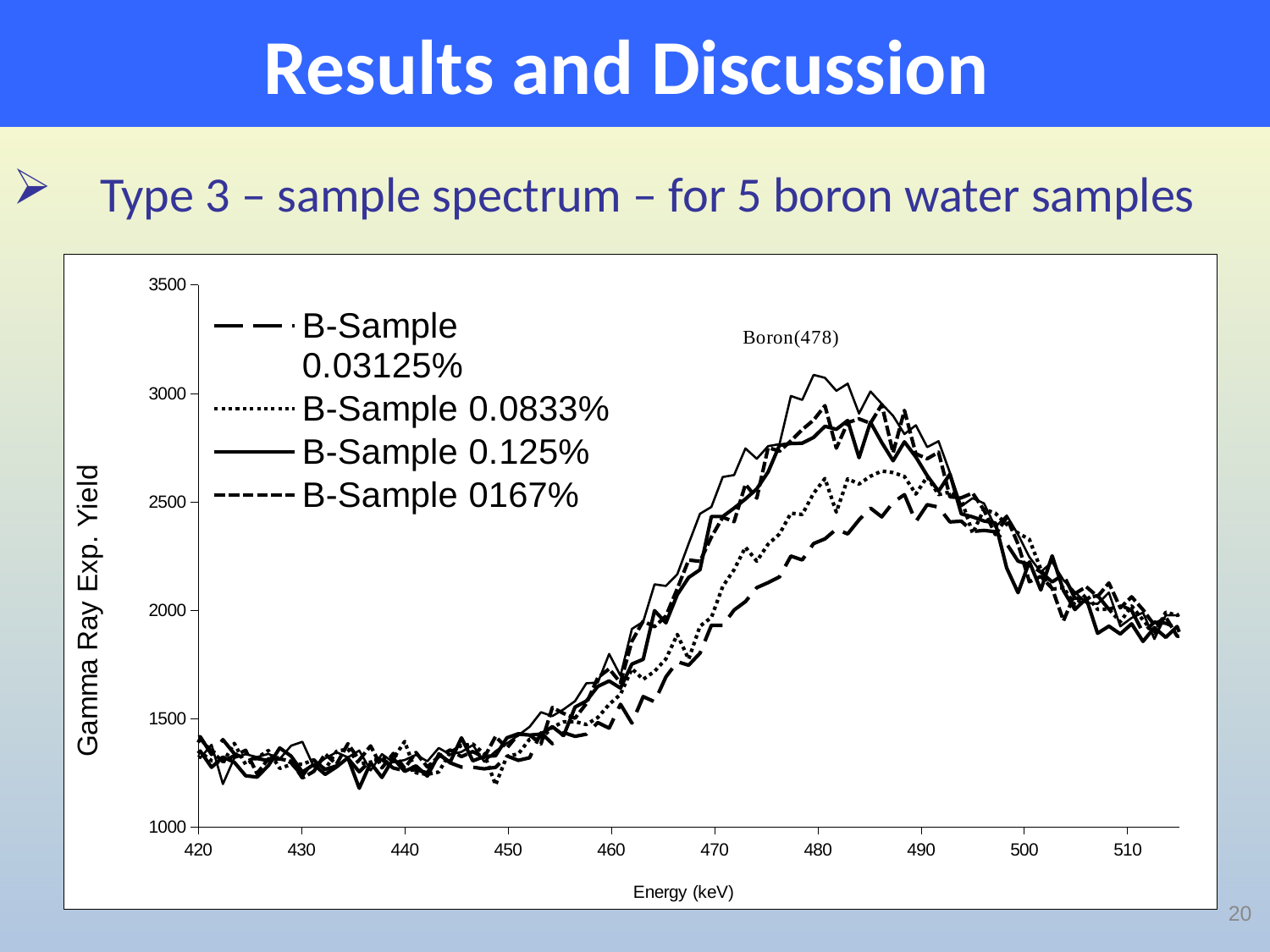
Is the value for B-Sample 0.125% at 420 keV greater or less than 1500? less Do the values rise or fall along the x axis between 450 keV and 480 keV? rise Is the value for B-Sample 0.03125% at 480 keV greater or less than 2500? less What kind of chart is shown on the slide? line chart What is the label of the x axis? Energy (keV) Is the value for B-Sample 0.0833% at 480 keV greater or less than 2000? greater At 480 keV, which series has the larger value: B-Sample 0.125% or B-Sample 0.03125%? B-Sample 0.125% Do the values rise or fall along the x axis between 490 keV and 510 keV? fall What is the label of the y axis? Gamma Ray Exp. Yield How many series does the legend list? 4